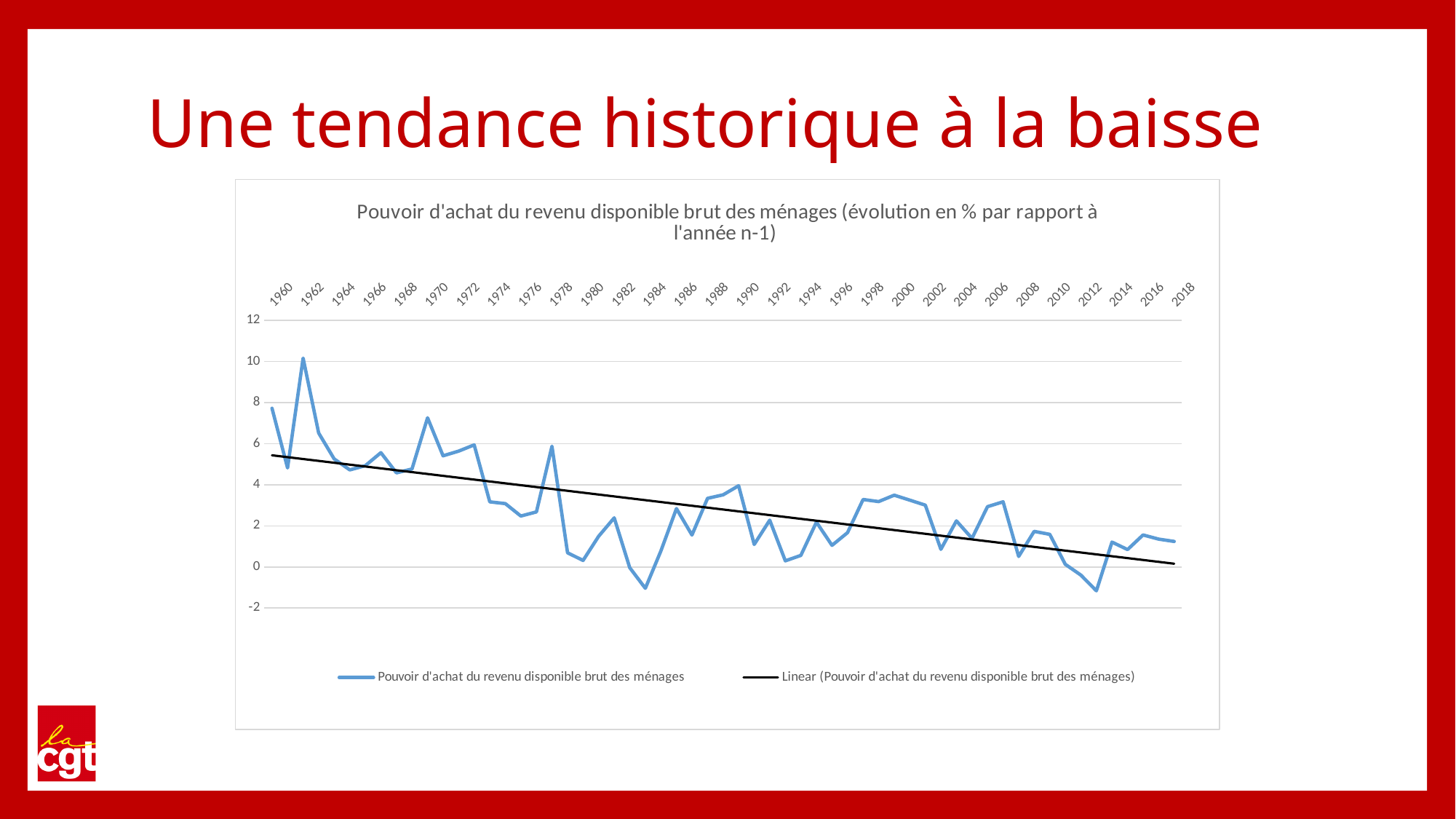
Which year has the larger value, 1962 or 1984? 1962 Is the value for 1970 greater or less than 6? greater Is the value for 1984 greater or less than 0? less What kind of chart is shown on the slide? line chart Is the value for 1962 greater or less than 8? greater In which year does the blue series reach its highest value? 1962 What colour is the line for 'Pouvoir d'achat du revenu disponible brut des ménages'? blue Does the black linear trend line rise or fall from left to right? fall Overall, do the values of the blue series rise or fall from 1960 to 2018? fall How many year labels are shown on the x axis? 30 How many series does the legend list? 2